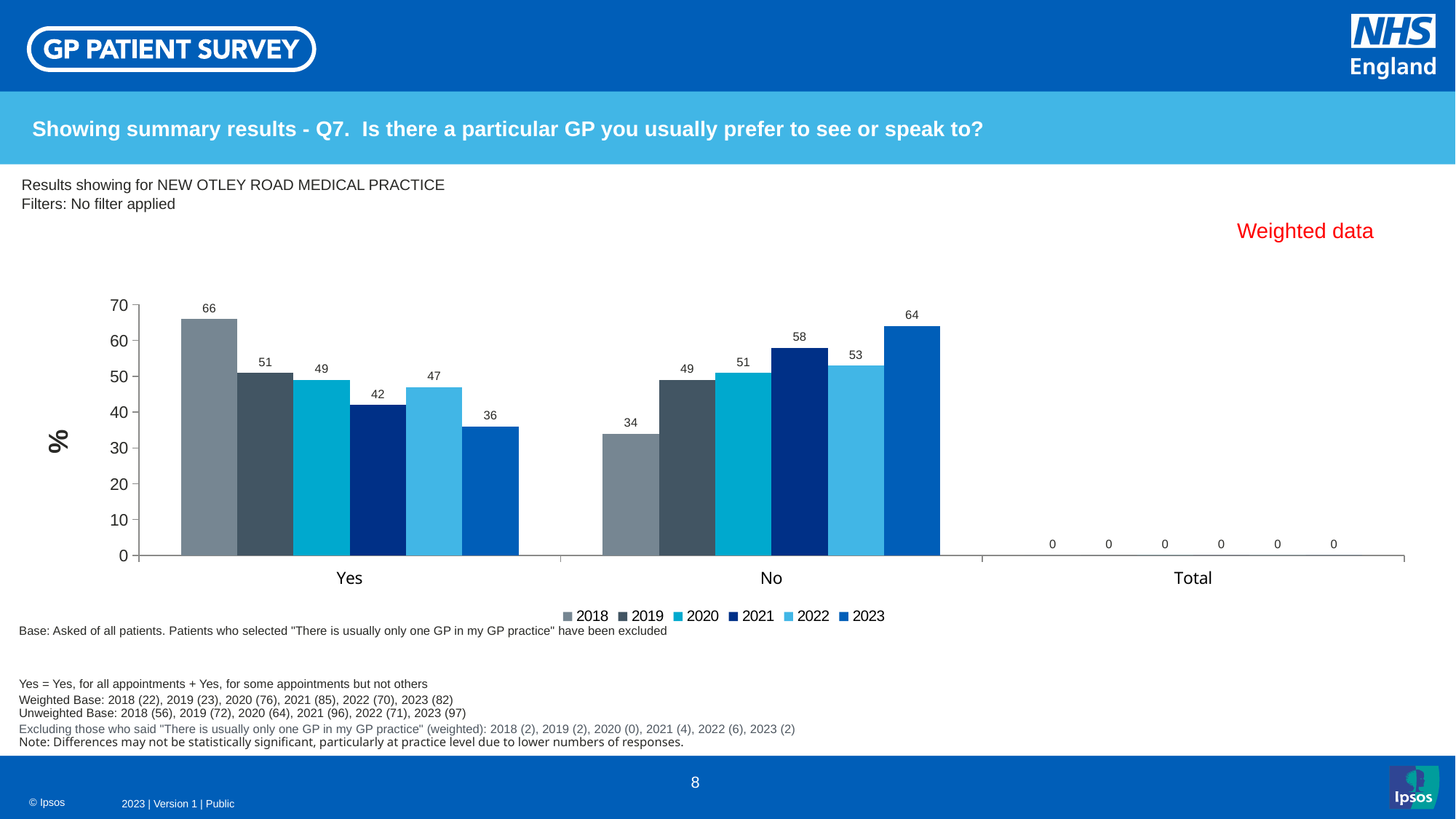
What is the value for 2023 in the No category? 64 How many series does the legend list? 6 What kind of chart is shown on the slide? Bar chart What is the difference between the 2018 and 2023 values in the Yes category? 30 What is the value for 2018 in the Yes category? 66 Do the values in the No category generally rise or fall from 2018 to 2023? Rise Which is larger: the 2021 value for No or the 2022 value for No? 2021 value for No How many categories are shown on the x axis? 3 Which year has the highest value in the Yes category? 2018 What is the value for 2021 in the Yes category? 42 Which year has the lowest value in the No category? 2018 What is the value for 2020 in the Total category? 0